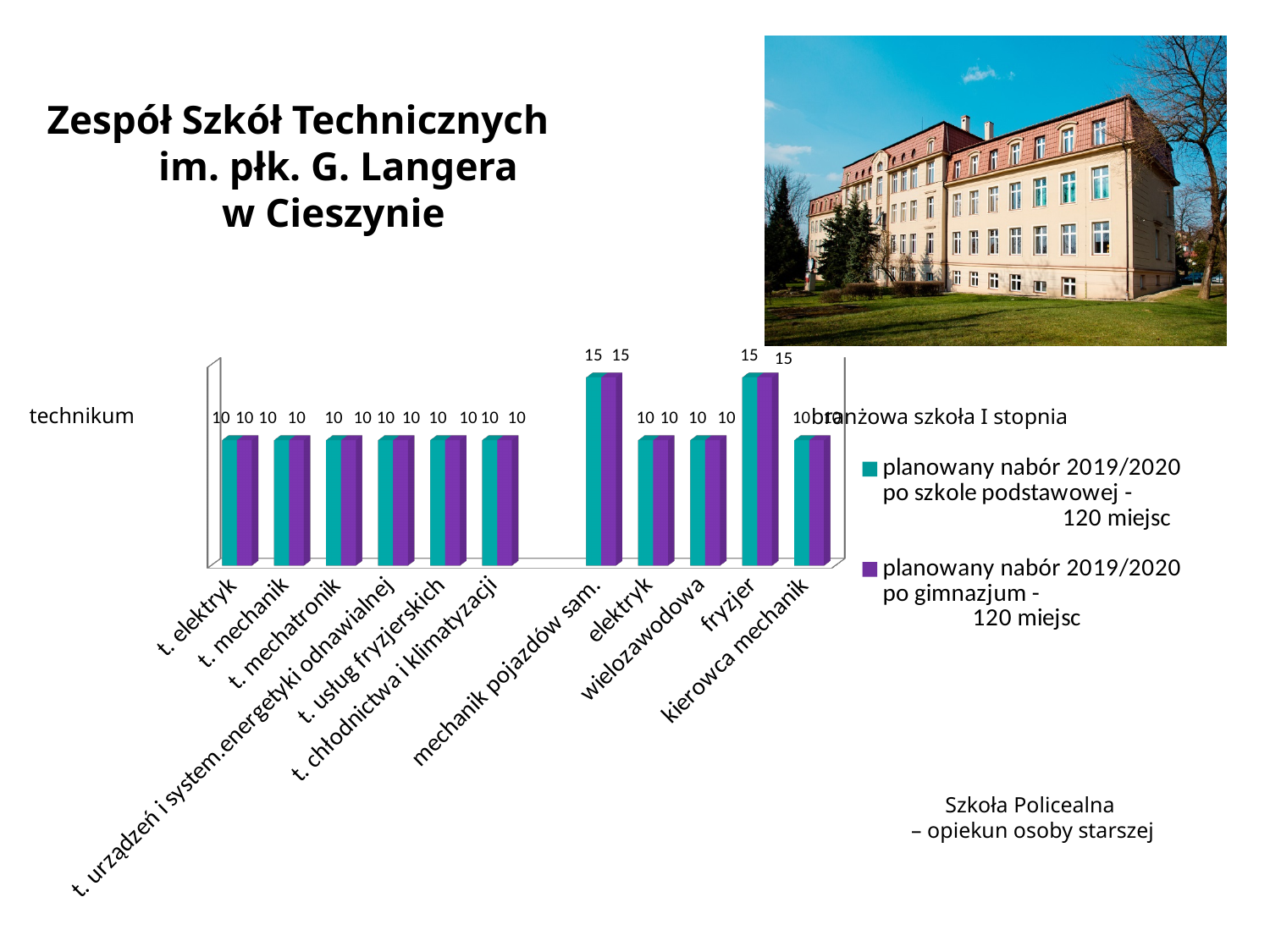
What is the value for 'mechanik pojazdów sam.' in the 'planowany nabór 2019/2020 po gimnazjum' series? 15 What colour are the bars for the 'planowany nabór 2019/2020 po gimnazjum' series? purple What is the difference between the 'planowany nabór 2019/2020 po gimnazjum' values for 'mechanik pojazdów sam.' and 'wielozawodowa'? 5 Which is larger in the 'planowany nabór 2019/2020 po szkole podstawowej' series: 'fryzjer' or 'elektryk'? fryzjer How many series does the chart legend list? 2 What is the value for 'kierowca mechanik' in the 'planowany nabór 2019/2020 po szkole podstawowej' series? 10 How many places does the legend state for the 'planowany nabór 2019/2020 po szkole podstawowej' series? 120 miejsc What is the value for 'fryzjer' in the 'planowany nabór 2019/2020 po szkole podstawowej' series? 15 What is the value for 't. mechanik' in the 'planowany nabór 2019/2020 po gimnazjum' series? 10 How many categories are shown on the chart's x axis? 11 What kind of chart is shown on the slide? bar chart Which two categories have the highest values in the chart? mechanik pojazdów sam. and fryzjer